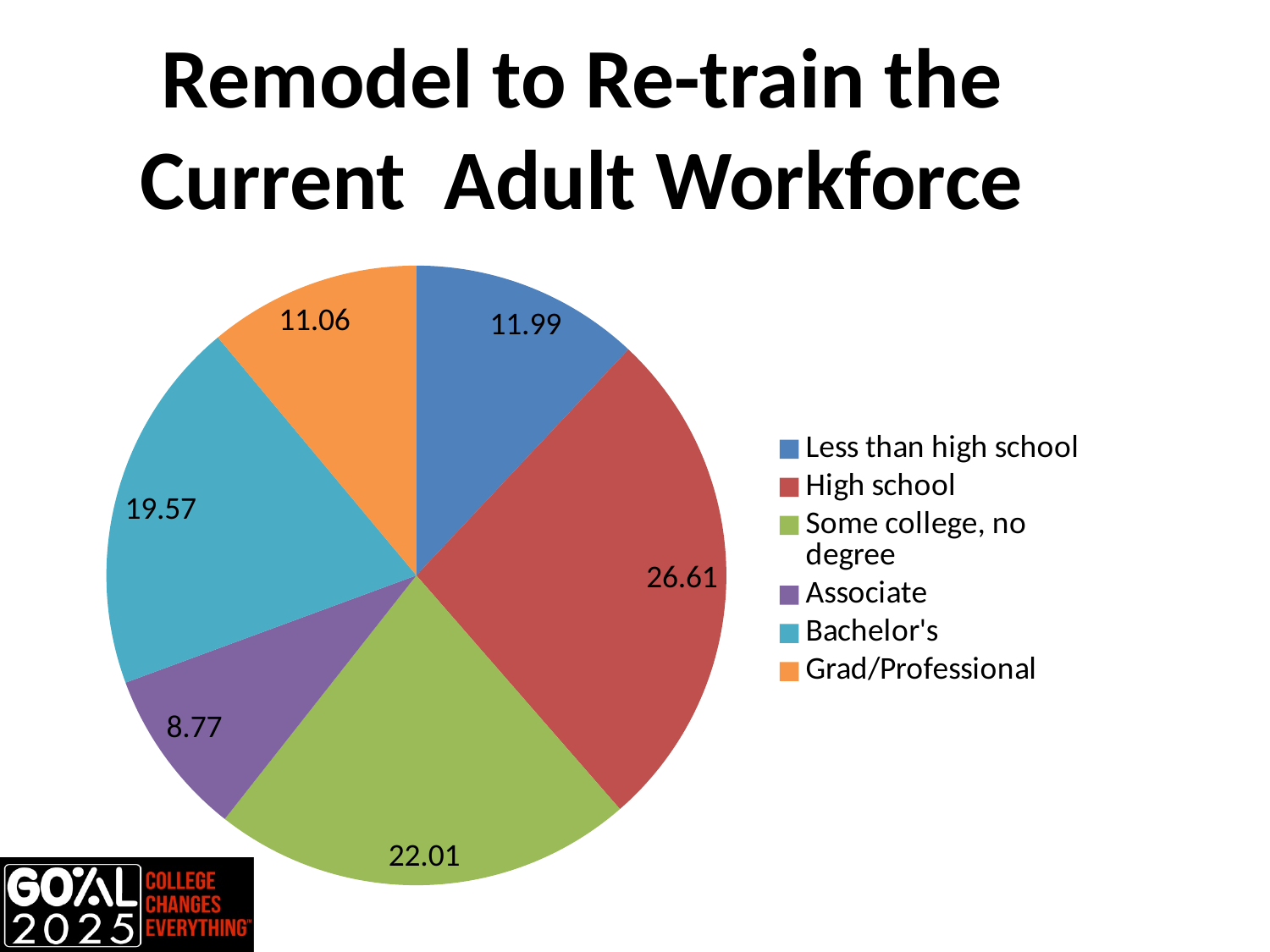
Which category has the smallest slice of the pie? Associate What is the difference between the Bachelor's value and the Associate value? 10.80 What is the value shown for the Grad/Professional slice? 11.06 What is the value shown for the Bachelor's slice? 19.57 What type of chart is shown on the slide? pie chart Which category has the largest slice of the pie? High school Which is larger, the Less than high school slice or the Grad/Professional slice? Less than high school What colour is the Some college, no degree slice? green What is the value shown for the High school slice? 26.61 How many categories does the legend list? 6 What is the value shown for the Associate slice? 8.77 What is the difference between the High school value and the Some college, no degree value? 4.60